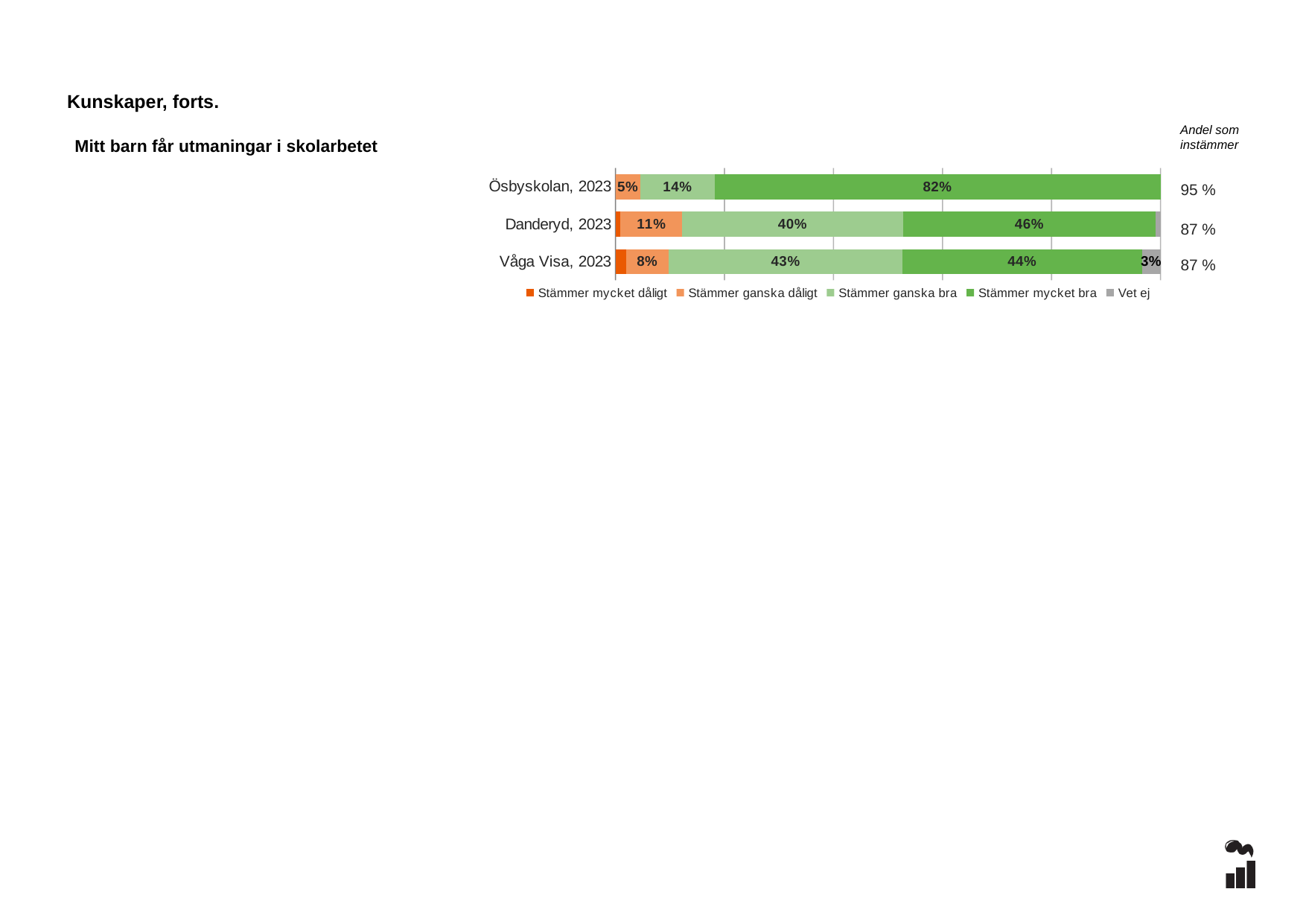
What is the "Stämmer ganska bra" value for Danderyd, 2023? 40% How many categories (bars) are shown in the chart? 3 What is the difference between the "Stämmer mycket bra" values for Ösbyskolan, 2023 and Danderyd, 2023? 36 percentage points What is the "Andel som instämmer" figure for Ösbyskolan, 2023? 95 % Which category has the highest "Stämmer mycket bra" share? Ösbyskolan, 2023 How many series does the legend list? 5 What is the "Stämmer ganska dåligt" value for Våga Visa, 2023? 8% What kind of chart is shown on the slide? Stacked bar chart Which category has the lowest "Stämmer ganska bra" share? Ösbyskolan, 2023 Which is larger: the "Stämmer ganska dåligt" value for Danderyd, 2023 or for Våga Visa, 2023? Danderyd, 2023 What percentage of Ösbyskolan, 2023 respondents answered "Stämmer mycket bra"? 82% What is the "Vet ej" value shown for Våga Visa, 2023? 3%